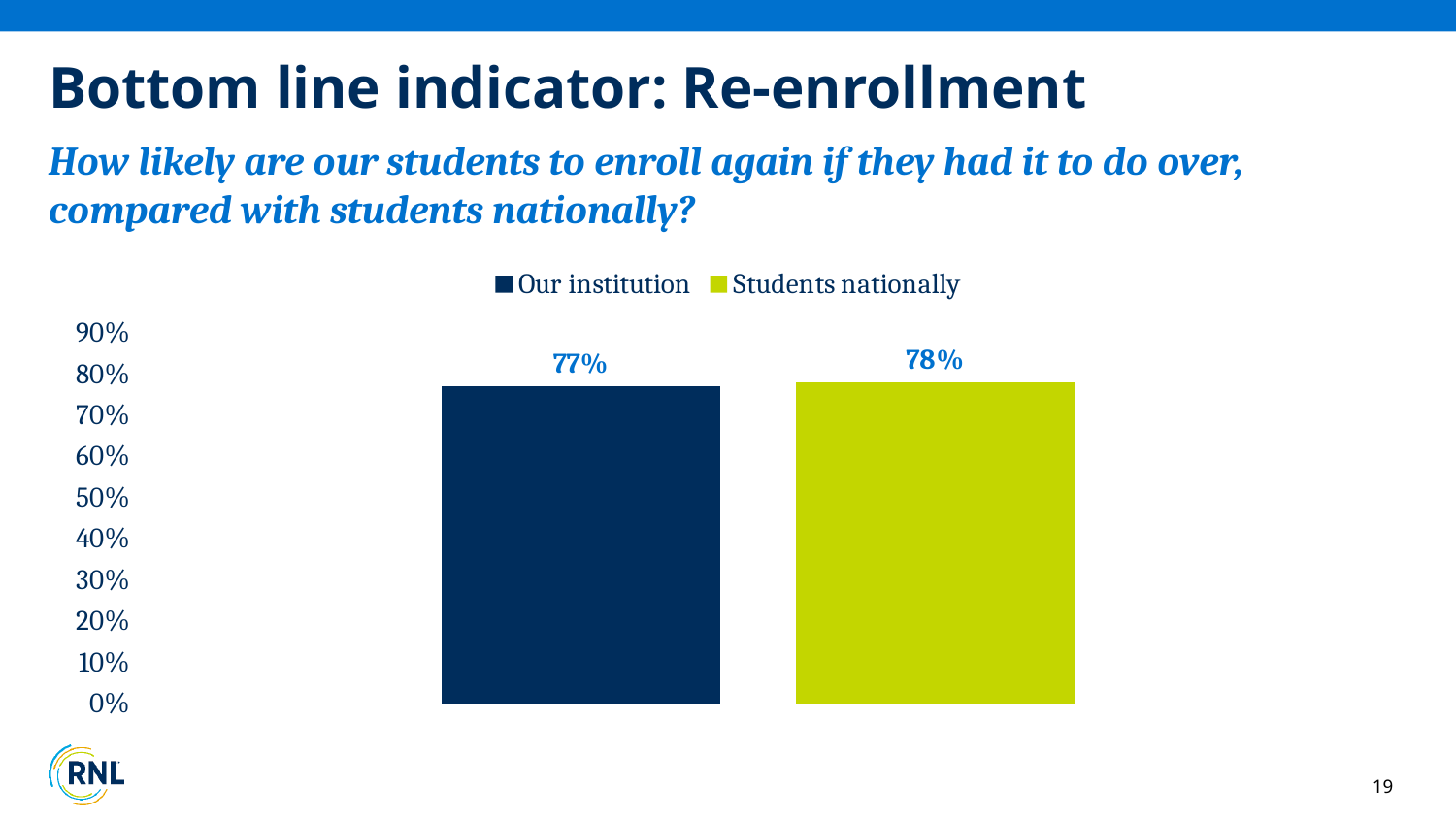
What kind of chart is shown on the slide? Bar chart Is the value for Our institution greater or less than 70%? greater What is the highest value shown on the y axis? 90% Which series has the higher value, Our institution or Students nationally? Students nationally How many series does the legend list? 2 How many bars are plotted on the chart? 2 What is the value for Students nationally? 78% What is the difference between the Students nationally value and the Our institution value? 1% What is the value for Our institution? 77% Is the value for Students nationally greater or less than 80%? less Which legend entry is shown in dark blue? Our institution